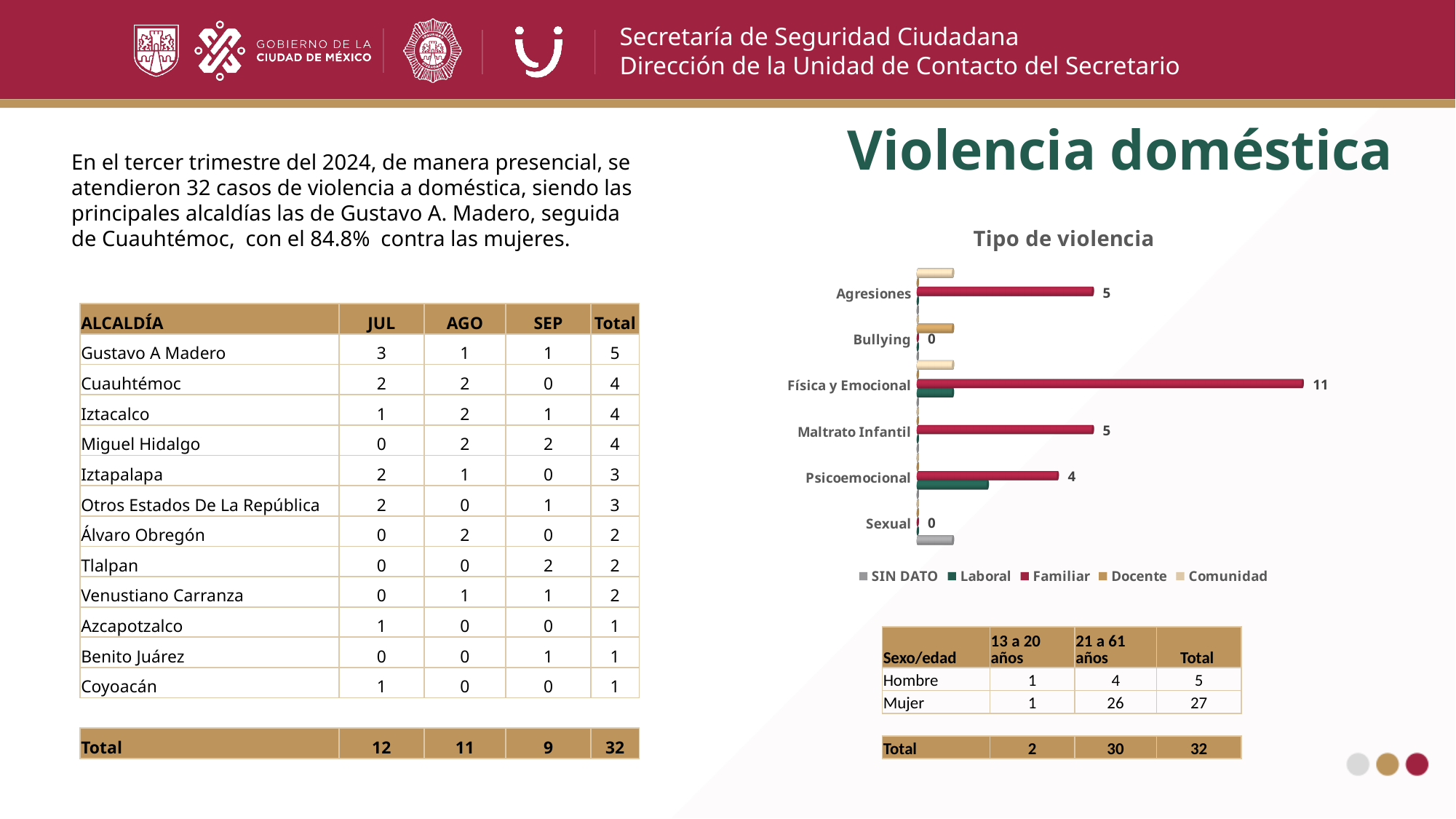
In the 'Tipo de violencia' chart, what is the Familiar value for Física y Emocional? 11 In the 'Tipo de violencia' chart, what is the Familiar value for Agresiones? 5 In the 'Tipo de violencia' chart, which category has the highest Familiar value? Física y Emocional In the 'Tipo de violencia' chart, what is the Familiar value for Bullying? 0 How many categories are shown on the y axis of the 'Tipo de violencia' chart? 6 In the 'Tipo de violencia' chart, what is the Familiar value for Psicoemocional? 4 How many series does the legend of the 'Tipo de violencia' chart list? 5 In the 'Tipo de violencia' chart, which has a larger Familiar value, Psicoemocional or Maltrato Infantil? Maltrato Infantil What is the title of the chart on the slide? Tipo de violencia In the 'Tipo de violencia' chart, what is the difference between the Familiar values for Física y Emocional and Maltrato Infantil? 6 Which series in the 'Tipo de violencia' chart is shown in dark red? Familiar What type of chart is 'Tipo de violencia'? bar chart